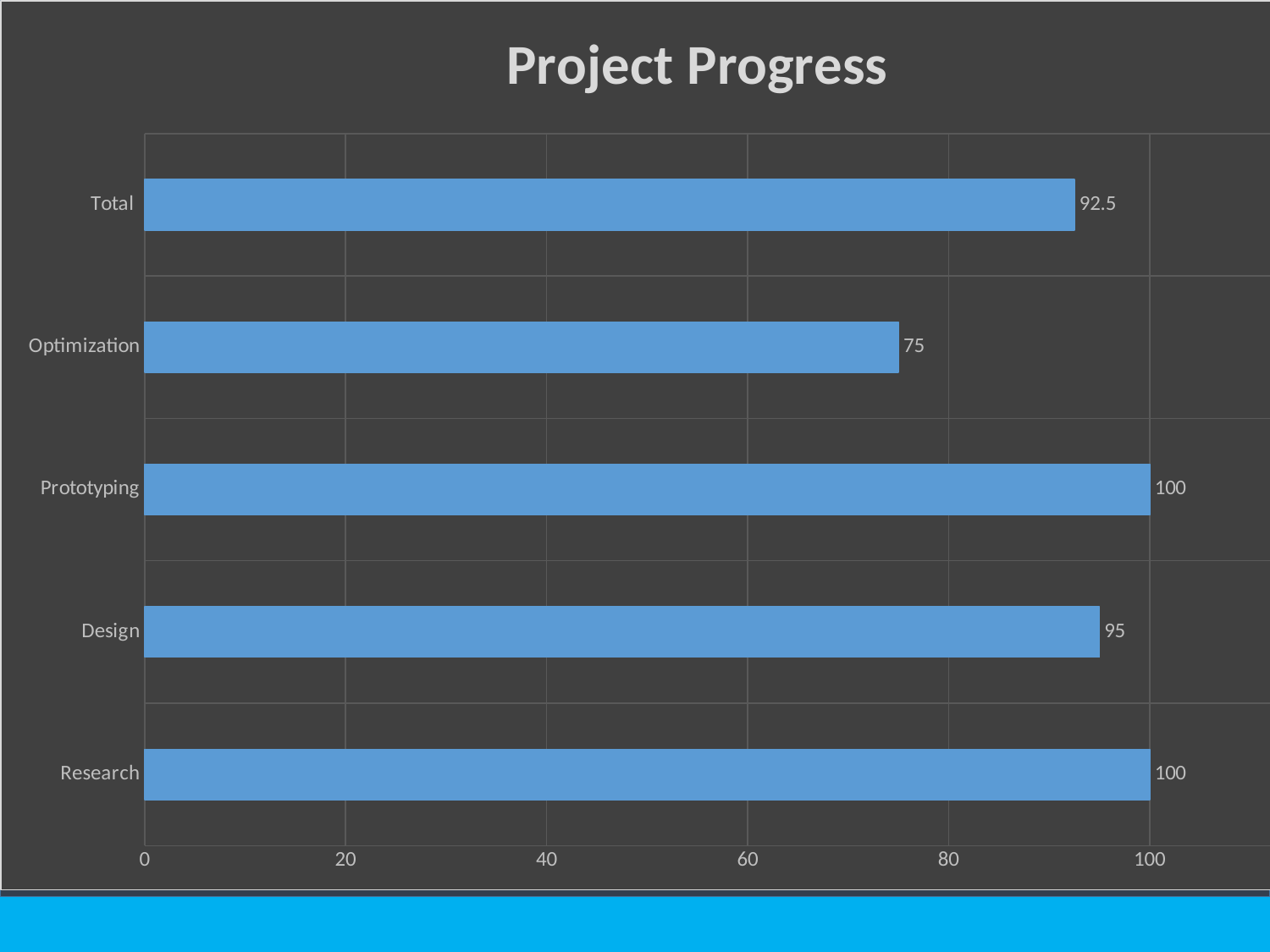
What kind of chart is shown? bar chart What is the difference between the values for Design and Optimization? 20 Which is larger, the value for Design or the value for Total? Design What is the value for Optimization? 75 Is the value for Optimization greater or less than 80? less What is the value for Total? 92.5 What is the difference between the values for Research and Total? 7.5 Which category has the lowest value? Optimization What is the value for Prototyping? 100 What is the value for Design? 95 How many categories are shown on the chart? 5 What is the title of the chart? Project Progress